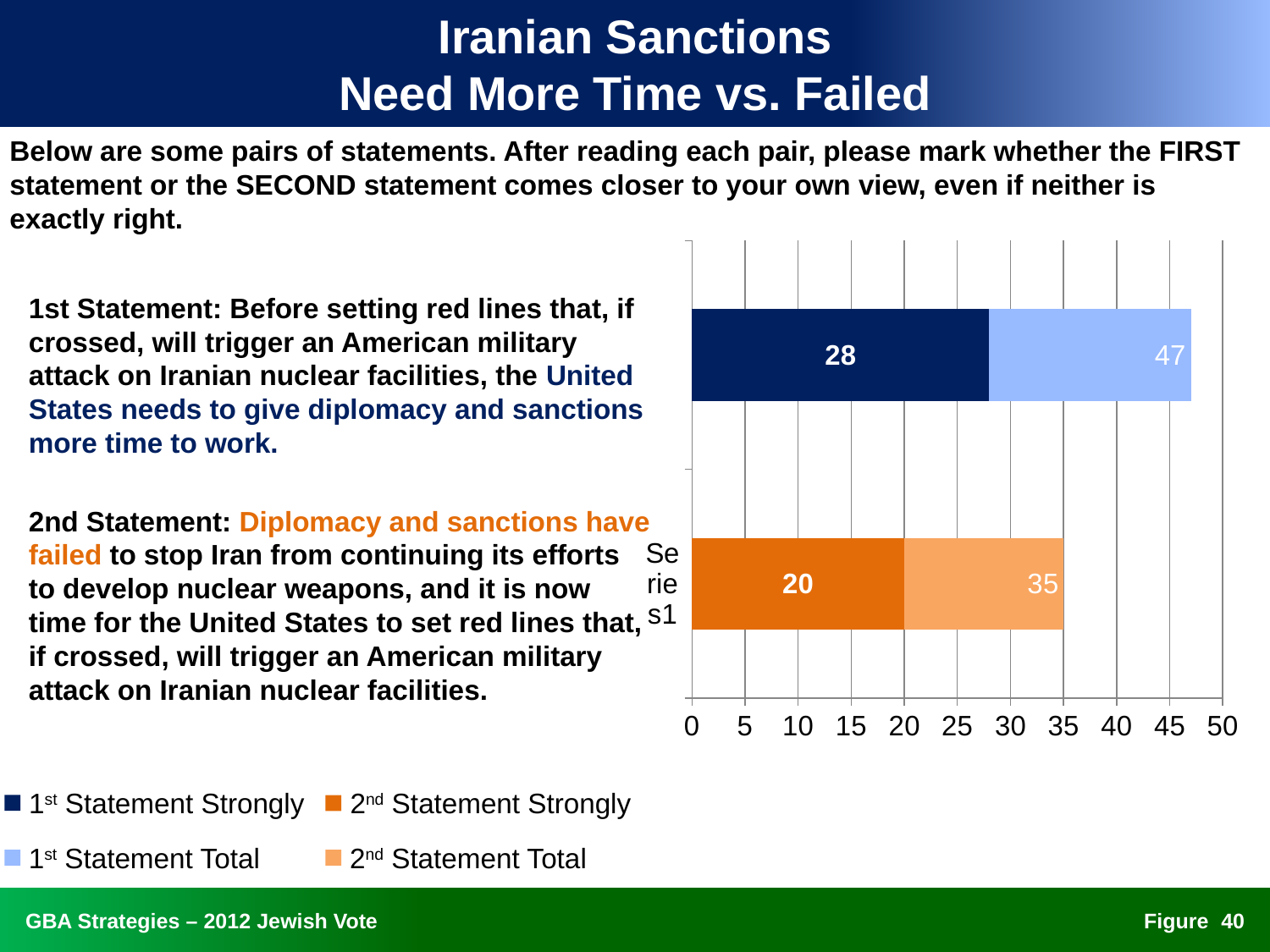
What value is shown for 1st Statement Total? 47 What kind of chart is shown on the slide? Bar chart Which legend entry has the highest value on the chart? 1st Statement Total What value is shown for 2nd Statement Strongly? 20 How many series does the legend list? 4 Which is larger, 1st Statement Strongly or 2nd Statement Strongly? 1st Statement Strongly Which legend entry has the lowest value on the chart? 2nd Statement Strongly What is the difference between the 1st Statement Total and the 2nd Statement Total? 12 What is the maximum value shown on the horizontal axis? 50 What value is shown for 2nd Statement Total? 35 What is the difference between 1st Statement Strongly and 2nd Statement Strongly? 8 What value is shown for 1st Statement Strongly? 28